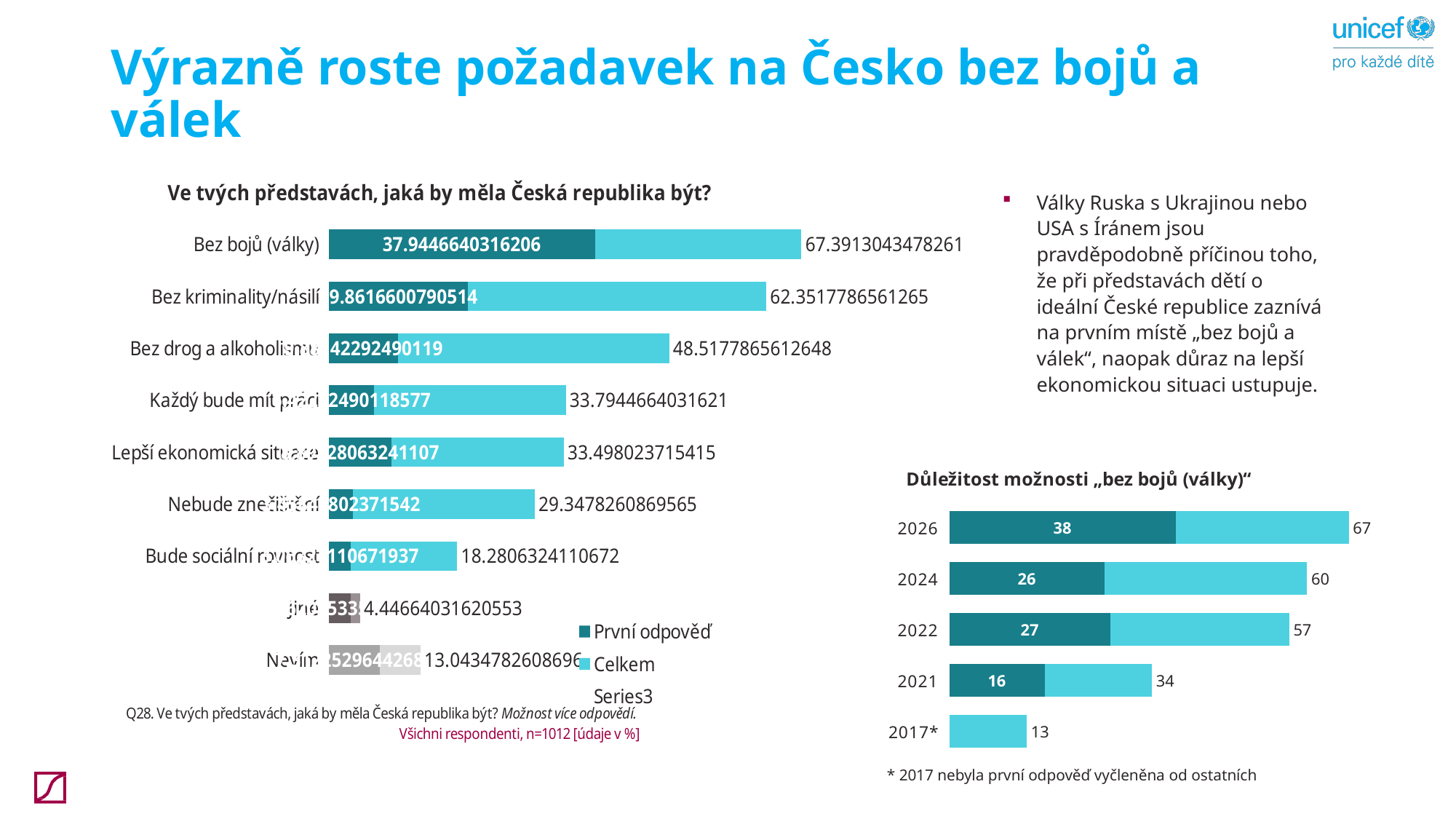
In the chart titled "Důležitost možnosti „bez bojů (války)“", what is the difference between the total values for 2026 and 2024? 7 In the chart titled "Důležitost možnosti „bez bojů (války)“", which year has the highest total value? 2026 In the chart titled "Důležitost možnosti „bez bojů (války)“", do the total values rise or fall from 2017* to 2026? rise In the chart titled "Ve tvých představách, jaká by měla Česká republika být?", which category has the highest Celkem value? Bez bojů (války) In the chart titled "Ve tvých představách, jaká by měla Česká republika být?", what is the První odpověď value for "Bez bojů (války)"? 37.9446640316206 In the chart titled "Důležitost možnosti „bez bojů (války)“", how many years are shown? 5 In the chart titled "Důležitost možnosti „bez bojů (války)“", what is the dark-bar (první odpověď) value for 2024? 26 In the chart titled "Důležitost možnosti „bez bojů (války)“", what is the total value shown for 2026? 67 In the chart titled "Důležitost možnosti „bez bojů (války)“", which year has the lowest value? 2017* In the chart titled "Ve tvých představách, jaká by měla Česká republika být?", how many series does the legend list? 3 In the chart titled "Ve tvých představách, jaká by měla Česká republika být?", what is the Celkem value for "Bez bojů (války)"? 67.3913043478261 What kind of chart is the one titled "Ve tvých představách, jaká by měla Česká republika být?"? bar chart